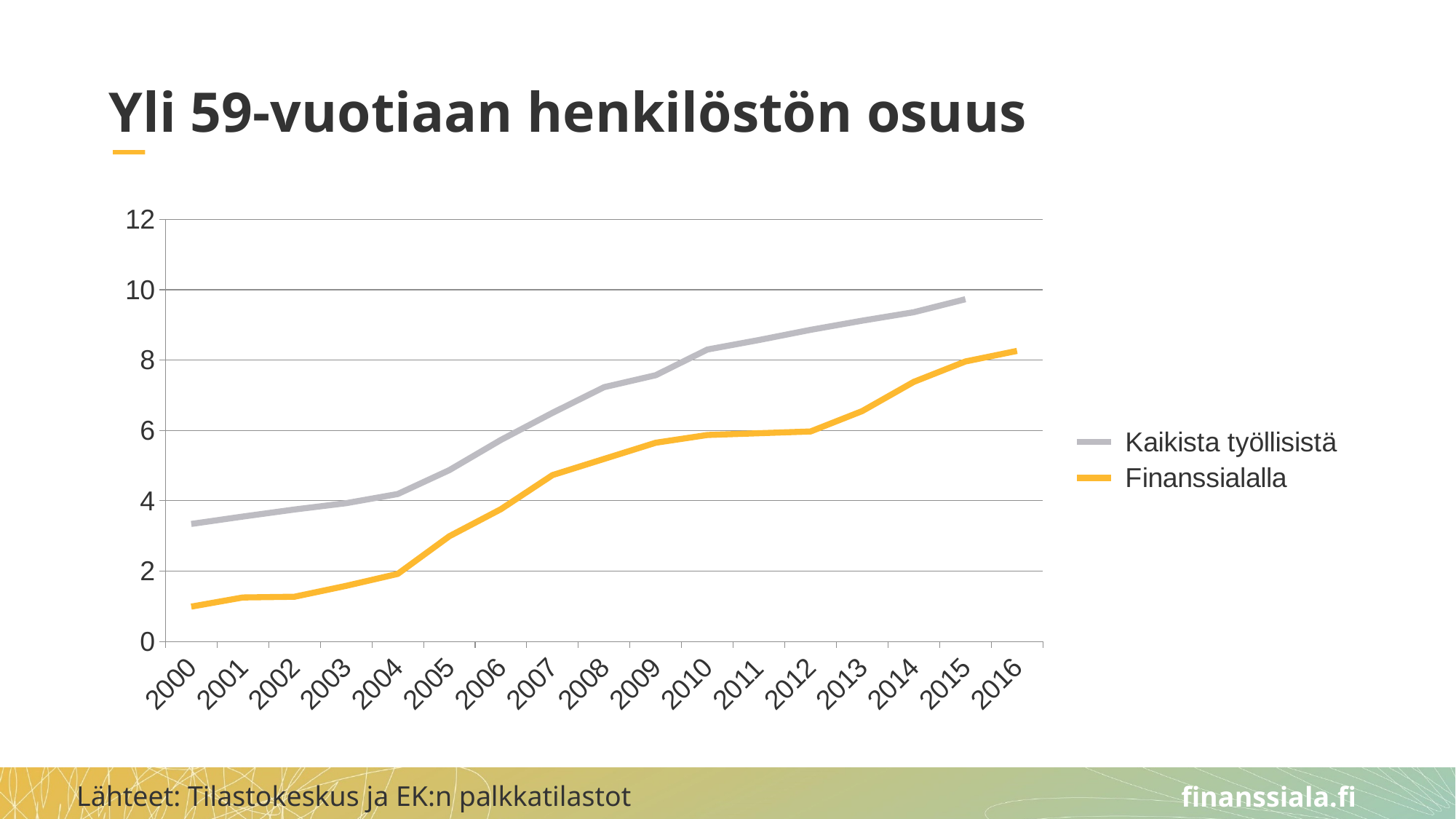
Is the value for Kaikista työllisistä in 2008 greater or less than 6? greater How many series does the legend list? 2 Is the value for Kaikista työllisistä in 2000 greater or less than 4? less What is the title of the chart? Yli 59-vuotiaan henkilöstön osuus Is the value for Finanssialalla in 2007 greater or less than 4? greater How many years are labelled on the x axis? 17 What kind of chart is shown on the slide? line chart In 2008, which series has the higher value, Kaikista työllisistä or Finanssialalla? Kaikista työllisistä Do the values for Finanssialalla rise or fall from 2000 to 2016? rise